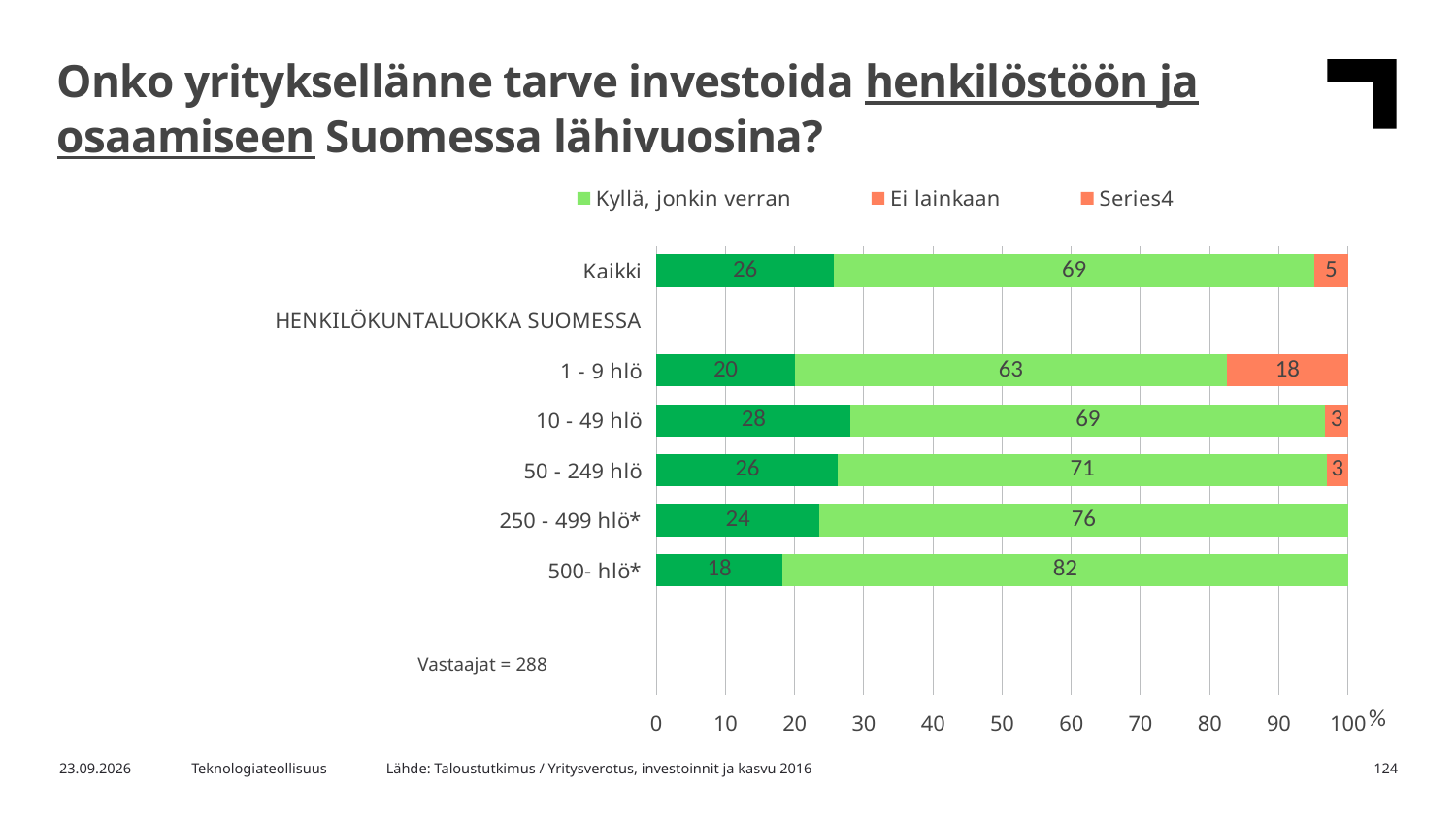
Which category has the largest orange 'Ei lainkaan' segment? 1 - 9 hlö Which has the larger dark green (first) segment: '10 - 49 hlö' or '50 - 249 hlö'? 10 - 49 hlö What is the difference between the 'Kyllä, jonkin verran' values for '500- hlö*' and '1 - 9 hlö'? 19 What is the total of the three labelled segments in the 'Kaikki' bar? 100 Which category has the smallest dark green (first) segment? 500- hlö* How many categories have bars plotted in the chart? 6 What is the value of the orange 'Ei lainkaan' segment for '1 - 9 hlö'? 18 What is the value of the 'Kyllä, jonkin verran' segment for '500- hlö*'? 82 What kind of chart is shown on the slide? Stacked bar chart What is the value of the 'Kyllä, jonkin verran' segment for 'Kaikki'? 69 How many series does the legend list? 3 Which category has the largest 'Kyllä, jonkin verran' segment? 500- hlö*